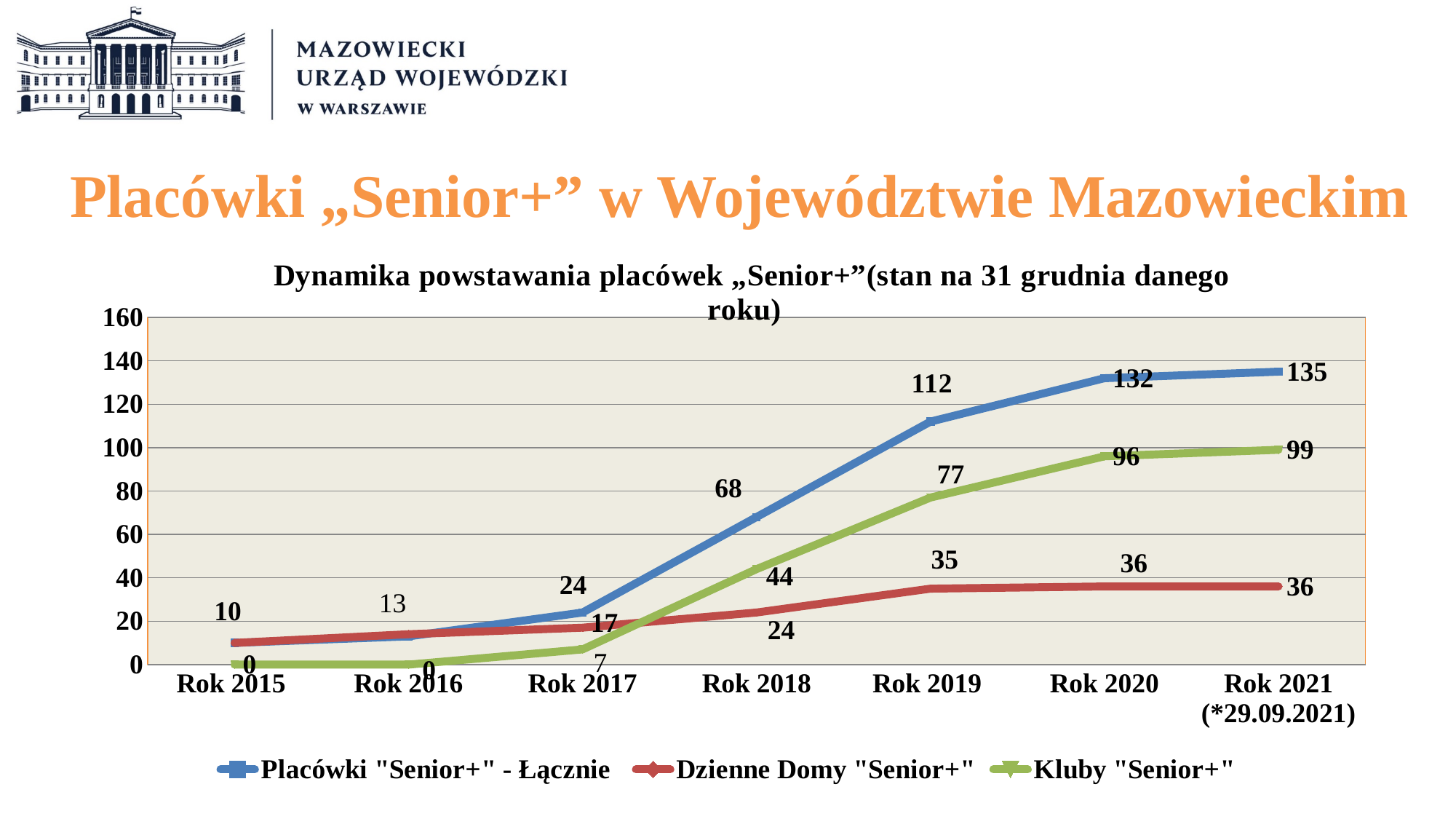
What is the value for Dzienne Domy "Senior+" in Rok 2018? 24 What is the title of the chart? Dynamika powstawania placówek „Senior+”(stan na 31 grudnia danego roku) Which is larger in Rok 2018: Dzienne Domy "Senior+" or Kluby "Senior+"? Kluby "Senior+" How many series does the legend list? 3 What is the value for Kluby "Senior+" in Rok 2017? 7 What type of chart is shown on the slide? line chart What is the value for Placówki "Senior+" - Łącznie in Rok 2021 (*29.09.2021)? 135 What is the difference between Placówki "Senior+" - Łącznie in Rok 2020 and Rok 2019? 20 In which year is Placówki "Senior+" - Łącznie highest? Rok 2021 (*29.09.2021) What is the value for Kluby "Senior+" in Rok 2019? 77 Does Kluby "Senior+" rise or fall from Rok 2017 to Rok 2021? rise How many years are shown on the x axis? 7